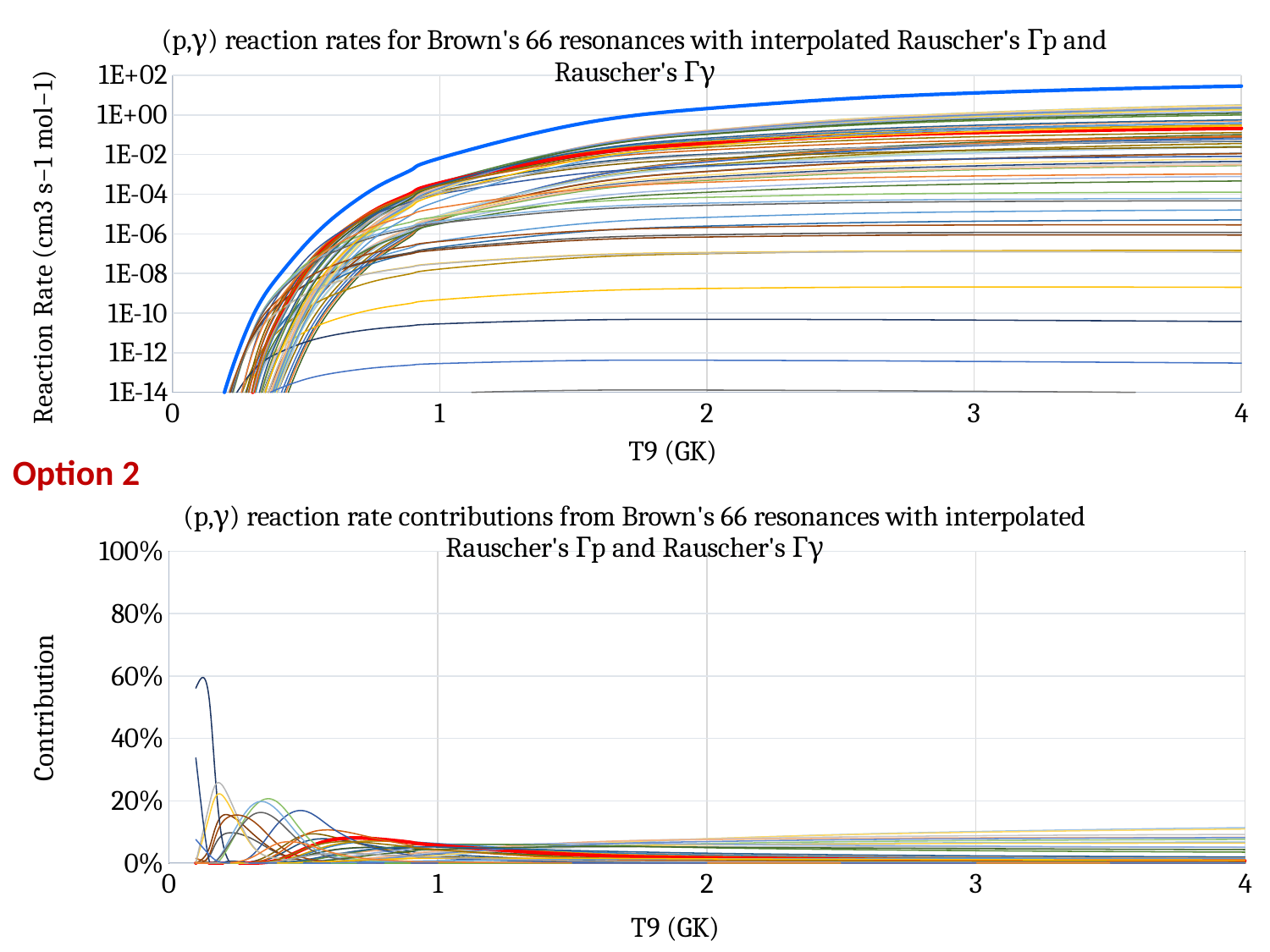
In the bottom chart, is the highest peak reached by any line greater or less than 40%? greater In the top chart, is the value of the thick blue line at T9 = 4 greater or less than 1E+00? greater In the bottom chart, are all contributions at T9 = 4 greater or less than 20%? less In the bottom chart, what is the highest value shown on the y axis? 100% What kind of chart is the bottom chart on the slide? line chart In the top chart, what is the lowest value shown on the y axis? 1E-14 What kind of chart is the top chart on the slide? line chart In the top chart, what is the label of the y axis? Reaction Rate (cm3 s-1 mol-1) In the bottom chart, does the thick red line rise or fall as T9 increases from 1 to 4? fall In the bottom chart, what is the label of the x axis? T9 (GK) In the top chart, do the reaction rates rise or fall as T9 increases from 0 to 4? rise